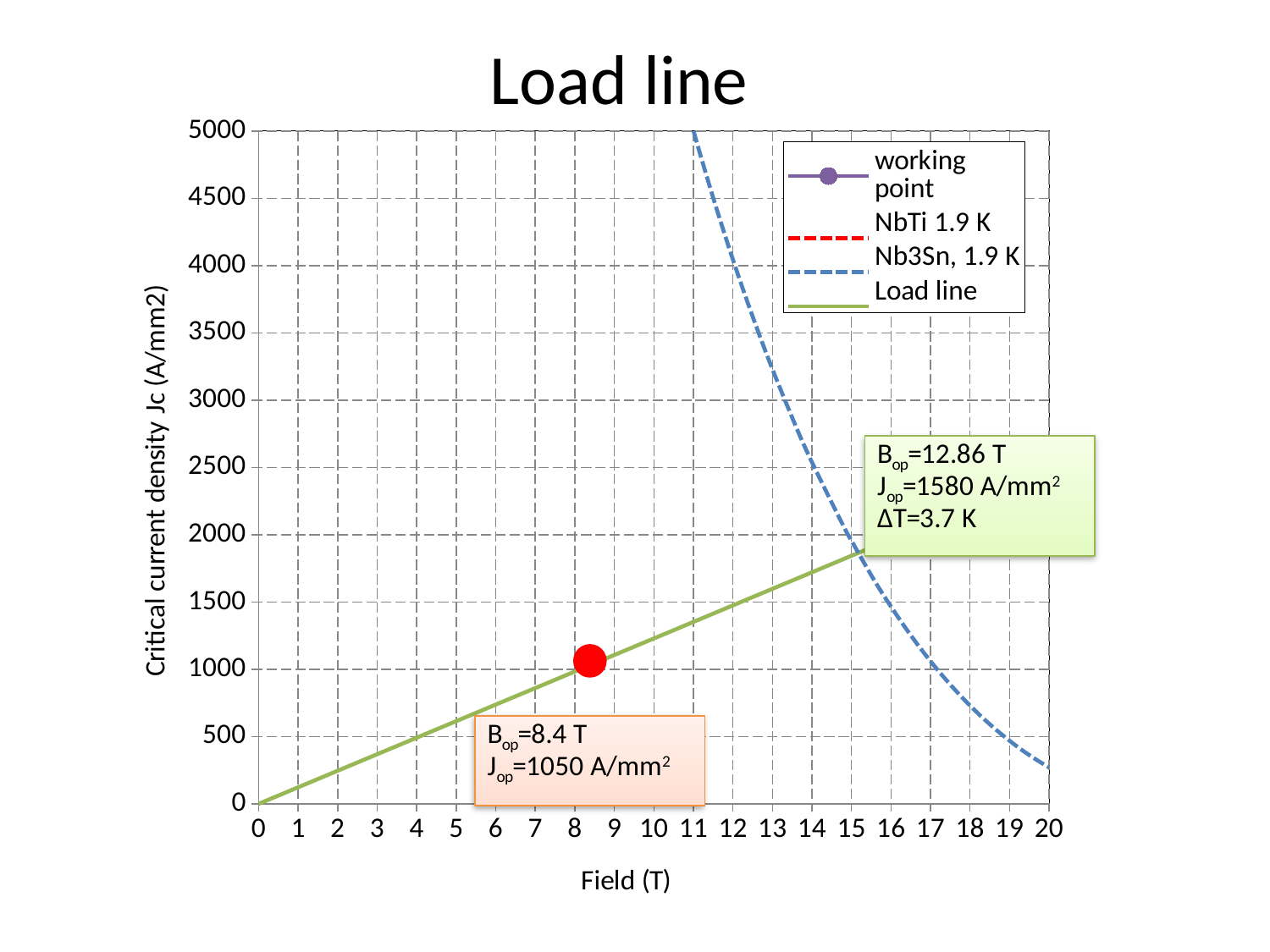
What is the label of the x axis? Field (T) What is the value of J_op given in the orange annotation box at the working point? 1050 A/mm² At a field of 12 T, which series has the higher value, Nb3Sn, 1.9 K or Load line? Nb3Sn, 1.9 K What is the value of ΔT given in the green annotation box? 3.7 K How many series does the legend list? 4 What is the value of B_op given in the orange annotation box at the working point? 8.4 T What is the title of the chart? Load line What is the value of B_op given in the green annotation box? 12.86 T Does the Load line series rise or fall as the field increases along the x axis? rise What is the difference between the J_op value in the green box and the J_op value in the orange box? 530 A/mm² What kind of chart is shown on the slide? line chart Is the value of the Nb3Sn, 1.9 K curve at 20 T greater or less than 500? less